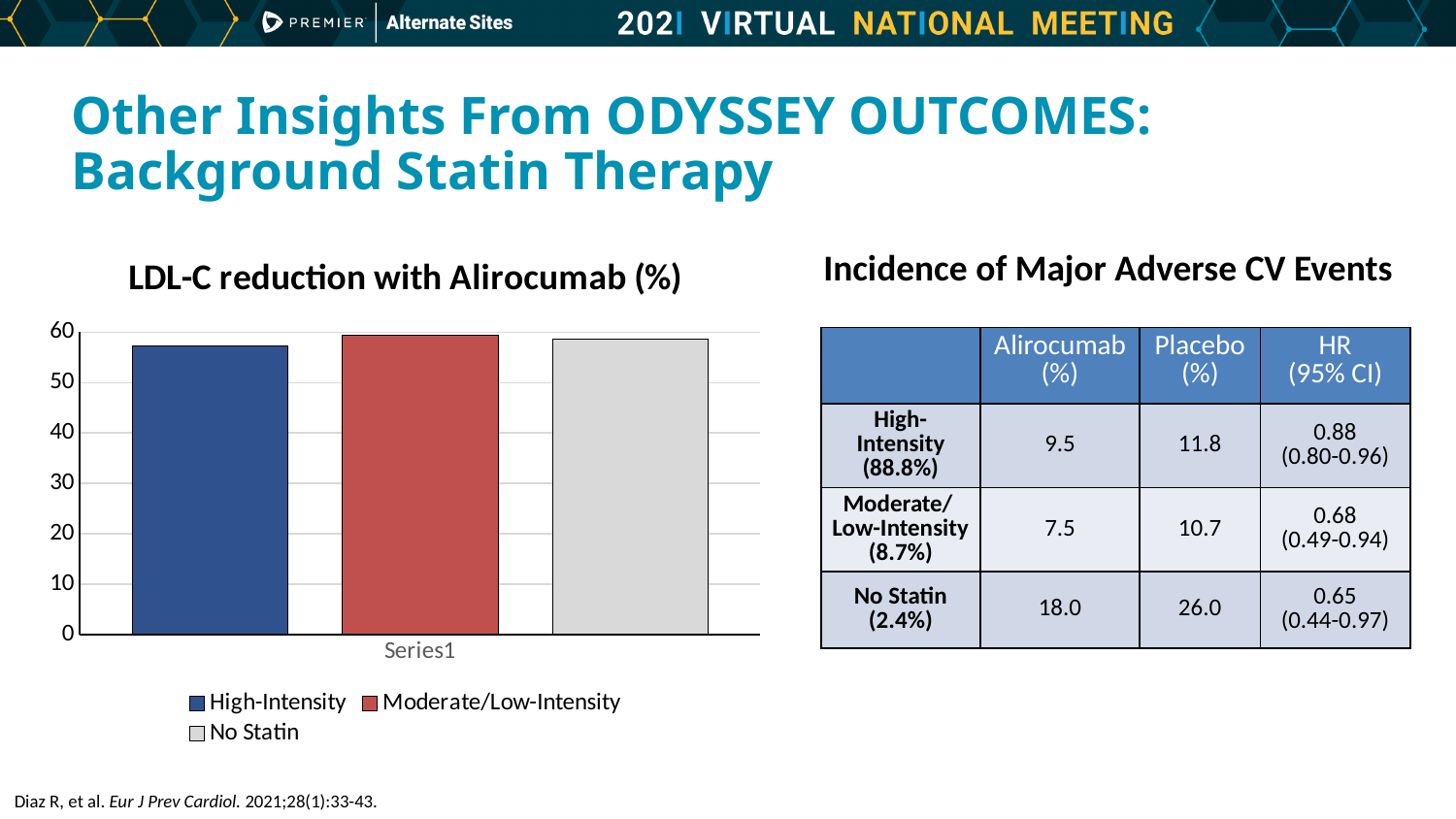
Is the value for Moderate/Low-Intensity greater or less than 40? greater Is the value for No Statin greater or less than 60? less How many series does the legend of the LDL-C reduction chart list? 3 What colour is the High-Intensity bar in the chart? blue What is the title of the chart on the slide? LDL-C reduction with Alirocumab (%) Which series has the lowest bar in the LDL-C reduction chart? High-Intensity What kind of chart is shown on the slide? bar chart How many bars are plotted in the LDL-C reduction chart? 3 Which is larger in the LDL-C reduction chart, the High-Intensity bar or the Moderate/Low-Intensity bar? Moderate/Low-Intensity Is the value for High-Intensity greater or less than 60? less